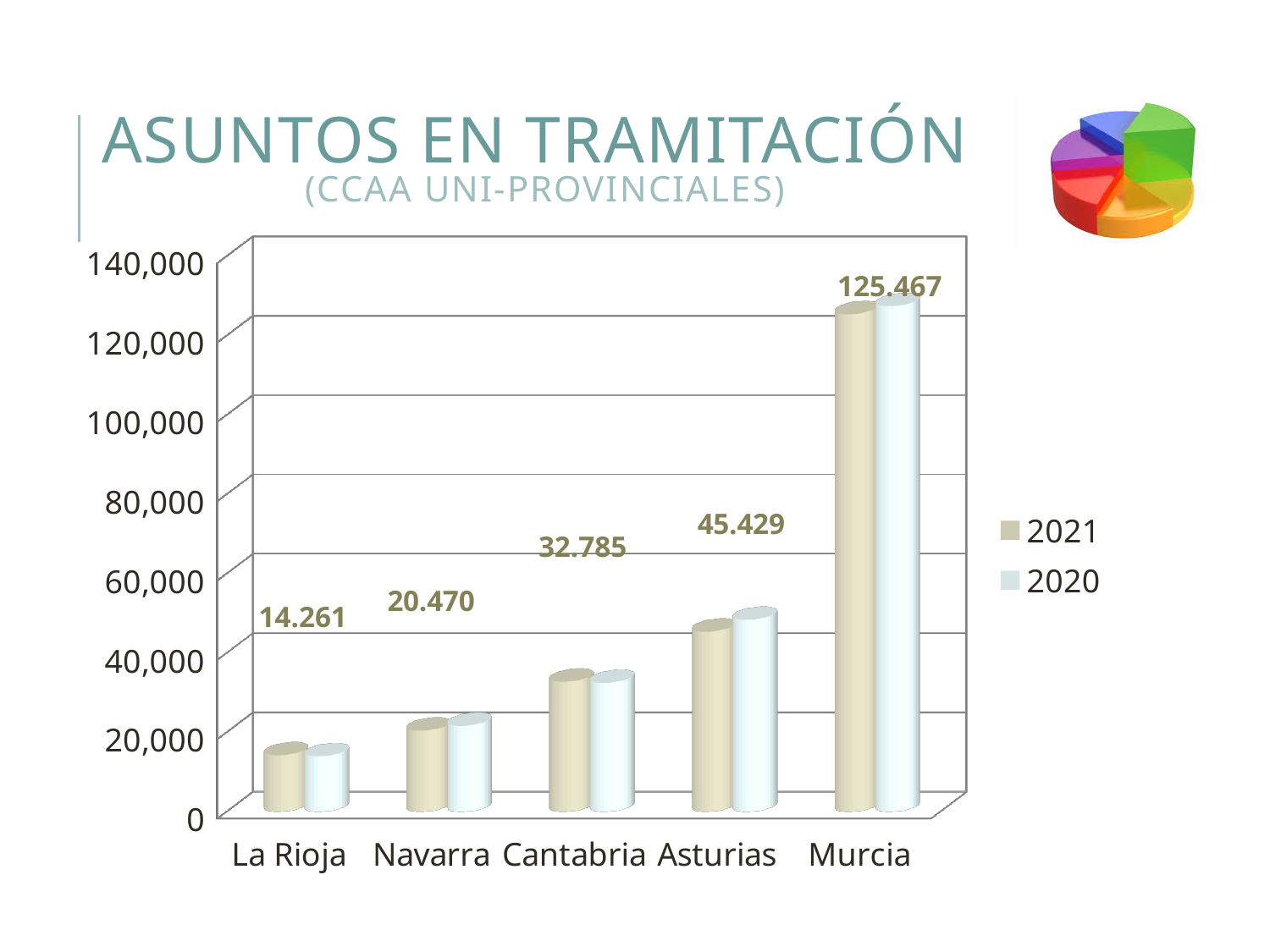
What kind of chart is shown on the slide? Bar chart How many series does the legend list? 2 What is the difference between the 2021 values for Asturias and Navarra? 24.959 Which region has the highest 2021 value? Murcia Is the 2020 value for Murcia greater or less than 100,000? greater What is the 2021 value for Cantabria? 32.785 What is the 2021 value for Murcia? 125.467 Which is larger, the 2021 value for Cantabria or the 2021 value for Navarra? Cantabria What is the 2021 value for La Rioja? 14.261 Is the 2020 value for La Rioja greater or less than 20,000? less Which region has the lowest 2021 value? La Rioja How many regions are shown on the x axis? 5